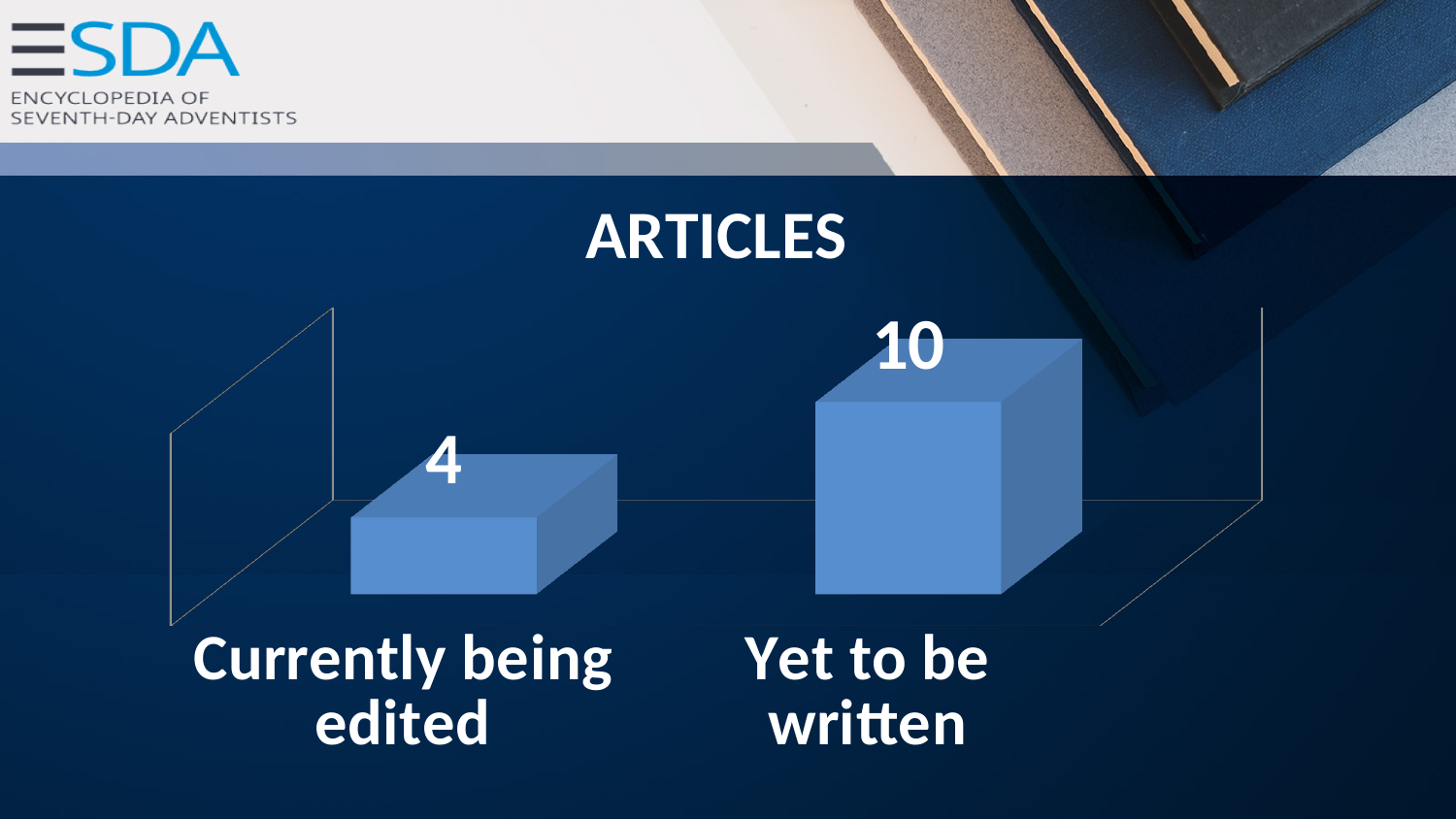
What is the value for "Yet to be written"? 10 What is the value for "Currently being edited"? 4 What is the total of the two values shown in the chart? 14 Do the values rise or fall from left to right across the categories? Rise Which category has the lowest value? Currently being edited How many categories are shown in the chart? 2 Which is larger, the value for "Currently being edited" or the value for "Yet to be written"? Yet to be written What kind of chart is shown on the slide? Bar chart What is the difference between the values for "Yet to be written" and "Currently being edited"? 6 What is the title of the chart? ARTICLES Which category has the highest value? Yet to be written